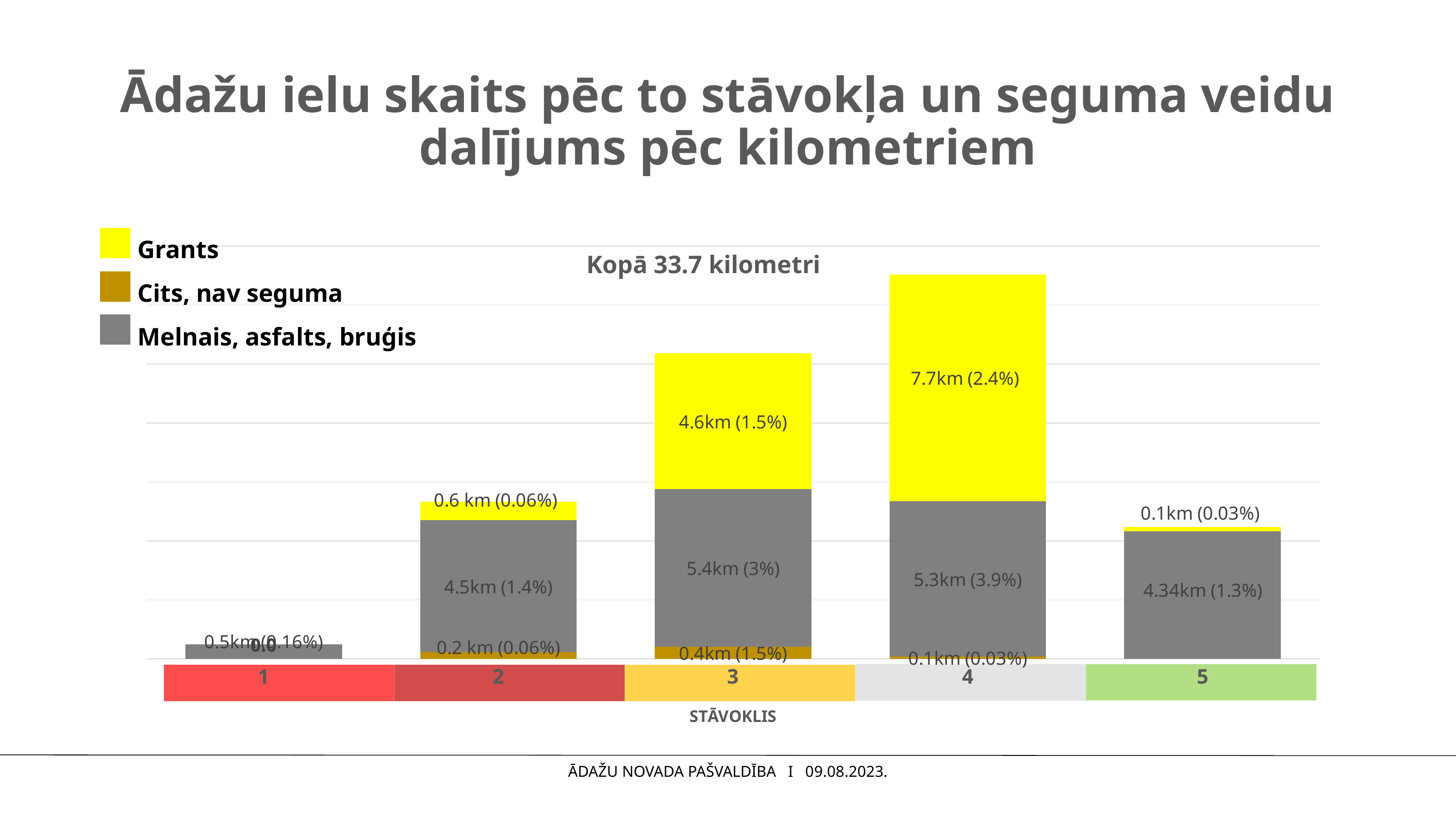
What is the value of the Melnais, asfalts, bruģis series for category 5? 4.34km (1.3%) What kind of chart is shown on the slide? stacked bar chart Which category has the shortest stacked bar? 1 What is the value of the Grants series for category 2? 0.6 km (0.06%) What is the value of the Cits, nav seguma series for category 3? 0.4km (1.5%) Which is larger: the Melnais, asfalts, bruģis value for category 3 or for category 4? category 3 How many series does the legend list? 3 What is the difference in kilometres between the Grants values for category 4 and category 3? 3.1km What is the value of the Grants series for category 4? 7.7km (2.4%) How many categories are shown on the x axis? 5 Which category has the tallest stacked bar? 4 What is the total length in kilometres of the stacked bar for category 3? 10.4km